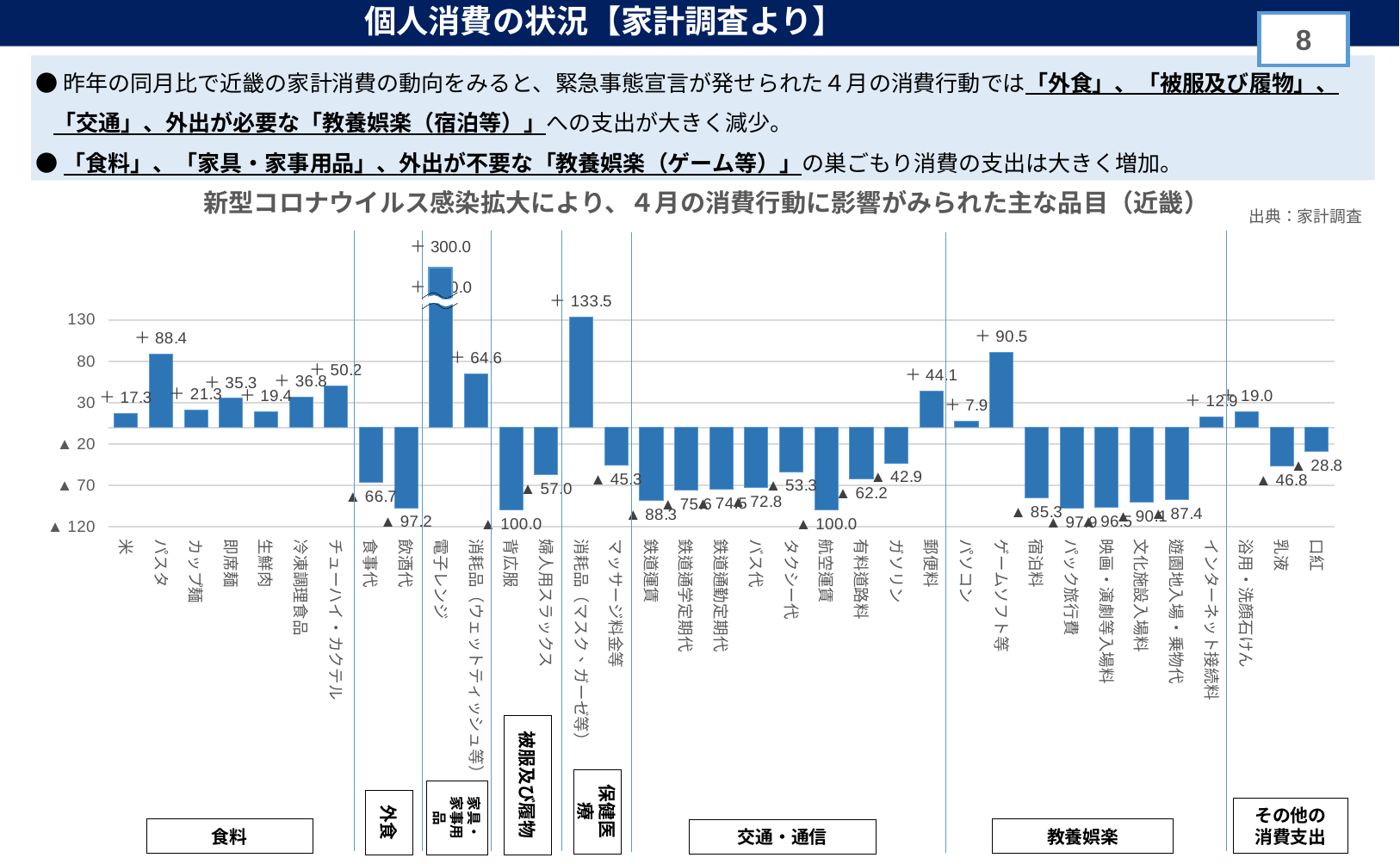
How many items (bars) are plotted in the chart? 35 What is the title of the chart? 新型コロナウイルス感染拡大により、４月の消費行動に影響がみられた主な品目（近畿） What is the value shown for パスタ? ＋88.4 Which item has the highest value in the chart? 電子レンジ Within the 交通・通信 group, which item has the lowest value? 航空運賃 What is the difference between the values for パスタ and 米? 71.1 What is the value shown for 消耗品（マスク・ガーゼ等）? ＋133.5 What is the value shown for 宿泊料? ▲85.3 What is the value shown for 食事代? ▲66.7 What is the value shown for ガソリン? ▲42.9 What kind of chart is shown on the slide? bar chart Which has the larger value, チューハイ・カクテル or 郵便料? チューハイ・カクテル